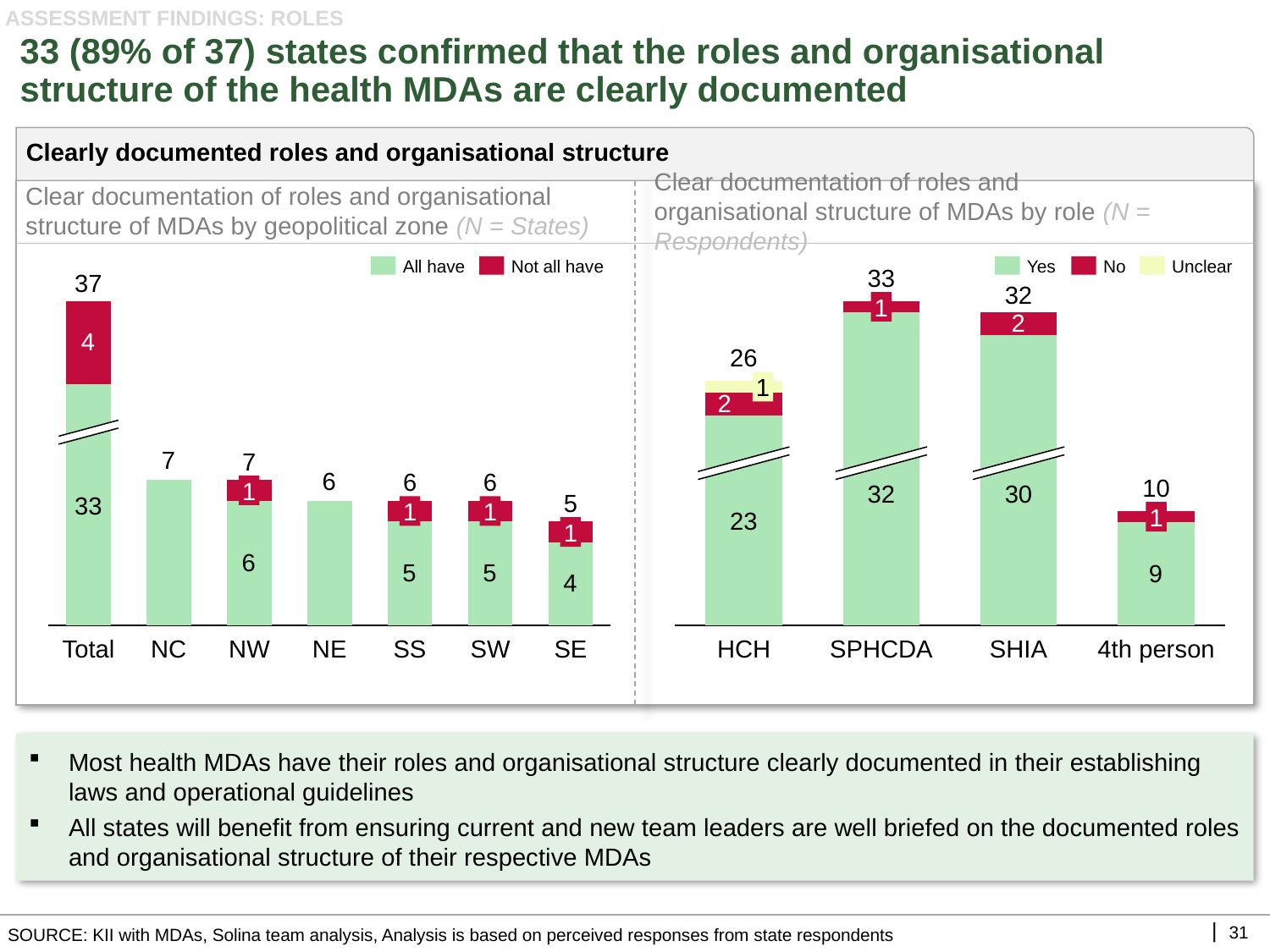
In the left chart (by geopolitical zone), how many categories are shown on the x axis? 7 In the right chart (by role), which is larger: the 'Yes' value for SPHCDA or the 'Yes' value for SHIA? SPHCDA In the left chart (by geopolitical zone), what is the 'Not all have' value for the Total bar? 4 In the left chart (by geopolitical zone), what is the 'All have' value for the Total bar? 33 In the left chart (by geopolitical zone), which zone (excluding Total) has the lowest bar total? SE In the left chart (by geopolitical zone), how many series does the legend list? 2 What type of chart is used in the right chart (by role)? Stacked bar chart In the right chart (by role), what is the 'Yes' value for HCH? 23 In the right chart (by role), what is the difference between the bar totals for SPHCDA and 4th person? 23 In the right chart (by role), which role has the highest bar total? SPHCDA In the right chart (by role), what is the 'No' value for SHIA? 2 In the left chart (by geopolitical zone), what is the total for the SE bar? 5